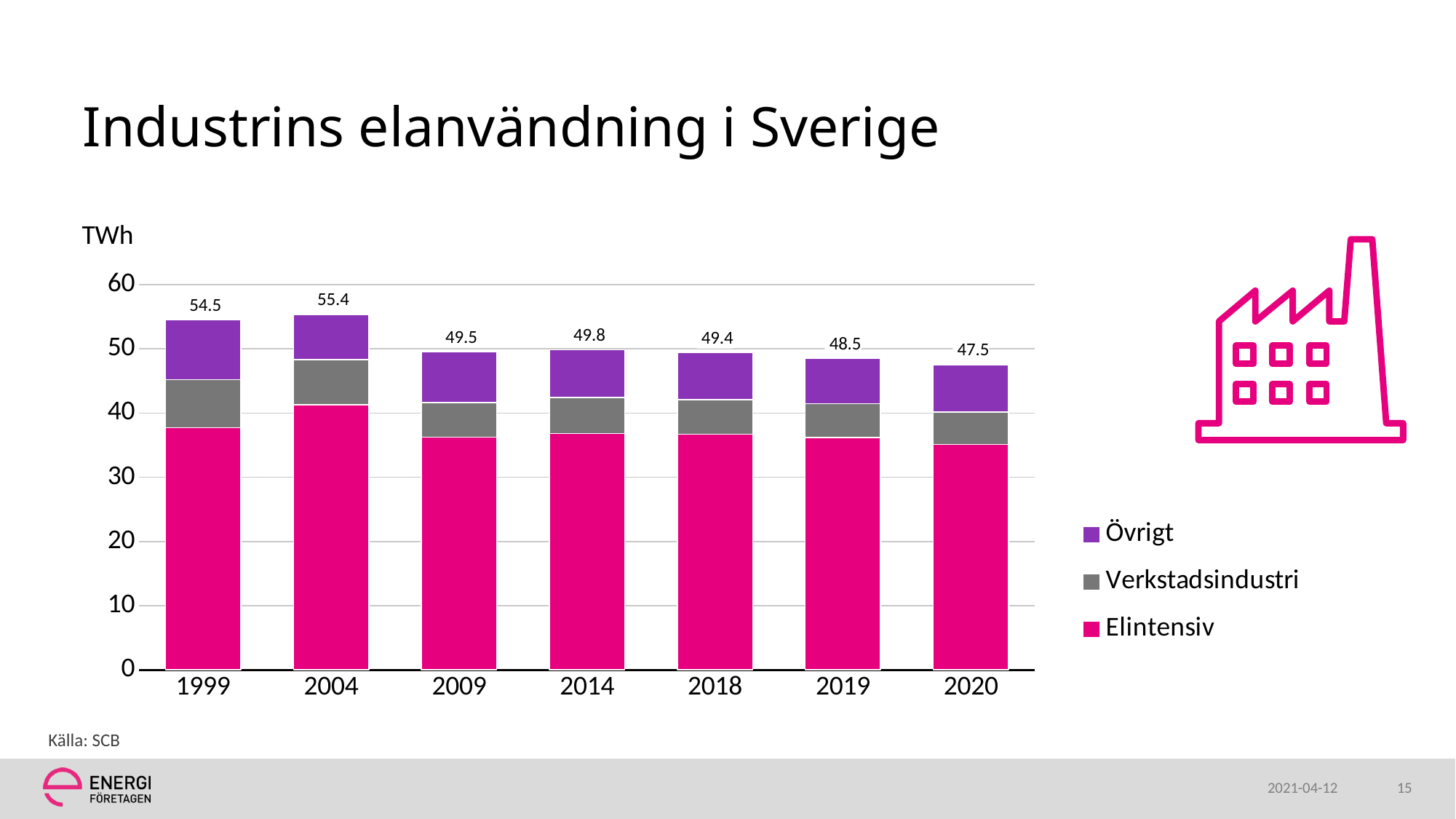
What is the total value shown for 2004? 55.4 How many series does the legend list? 3 Which total is larger, 2009 or 2019? 2009 Which year has the lowest total? 2020 What is the total value shown for 2020? 47.5 What kind of chart is shown? Stacked bar chart Is the Elintensiv value for 2004 greater or less than 40? greater What unit is shown on the y axis? TWh What is the total value shown for 2014? 49.8 How many years are shown on the x axis? 7 Which year has the highest total? 2004 What is the difference between the totals for 1999 and 2020? 7.0